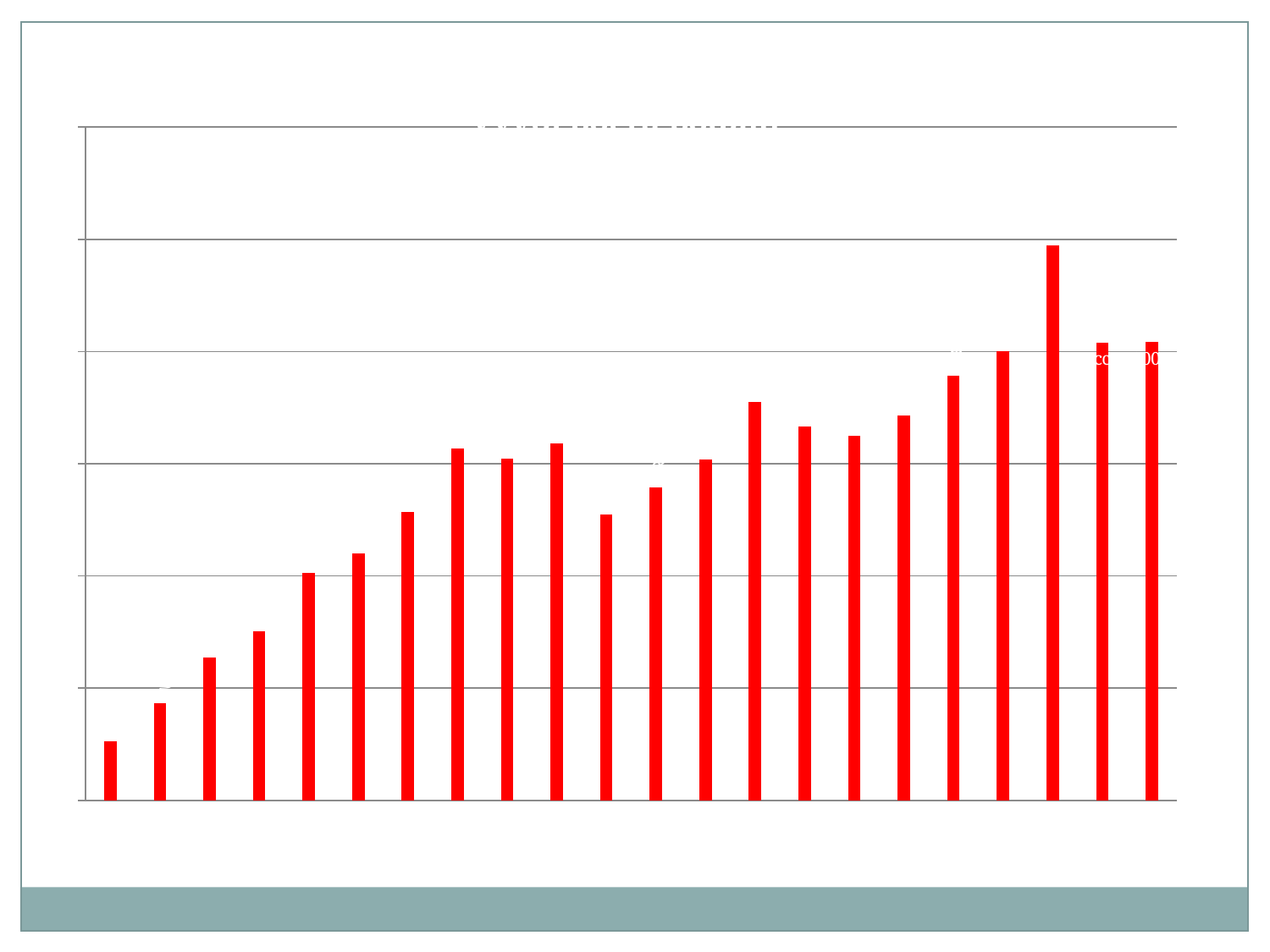
Do the bar values generally rise or fall from left to right across the chart? rise Which bar is the shortest in the chart? the leftmost (first) bar Which bar is the tallest in the chart, counting from the left? the 20th bar (third from the right) What colour are the bars in the chart? red Does the chart show a legend? no What kind of chart is shown on the slide? bar chart Which is taller, the first bar or the second bar from the left? the second bar How many bars are plotted in the chart? 22 Which is taller, the tallest bar (third from the right) or the rightmost bar? the third from the right Which is taller, the leftmost bar or the rightmost bar? the rightmost bar